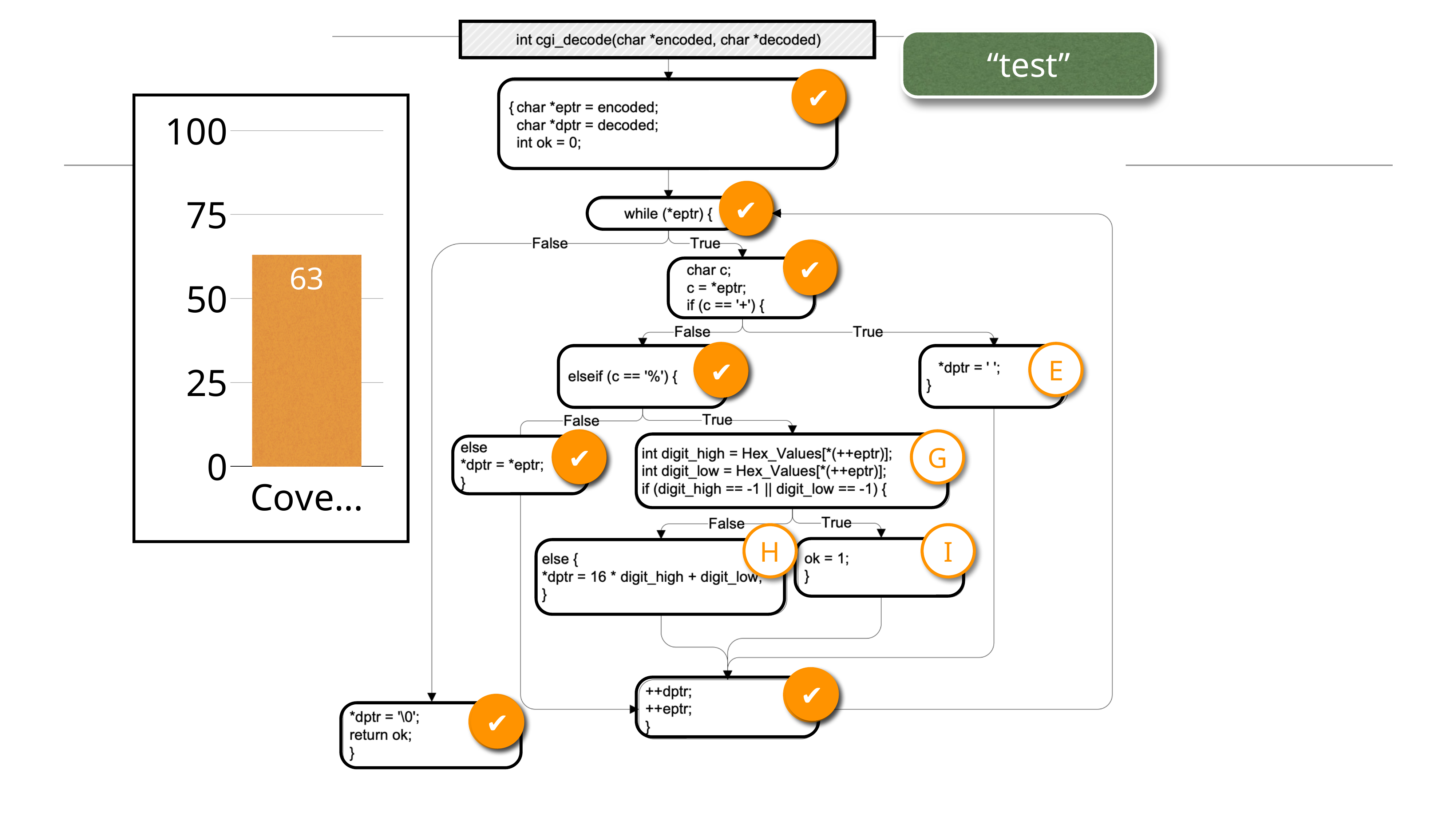
What is the lowest tick value shown on the chart's vertical axis? 0 Is the value of the bar greater or less than 50? greater What value is printed on the bar in the chart? 63 What kind of chart is shown on the left of the slide? bar chart What is the highest tick value shown on the chart's vertical axis? 100 Is the value of the bar greater or less than 75? less How many bars does the chart contain? 1